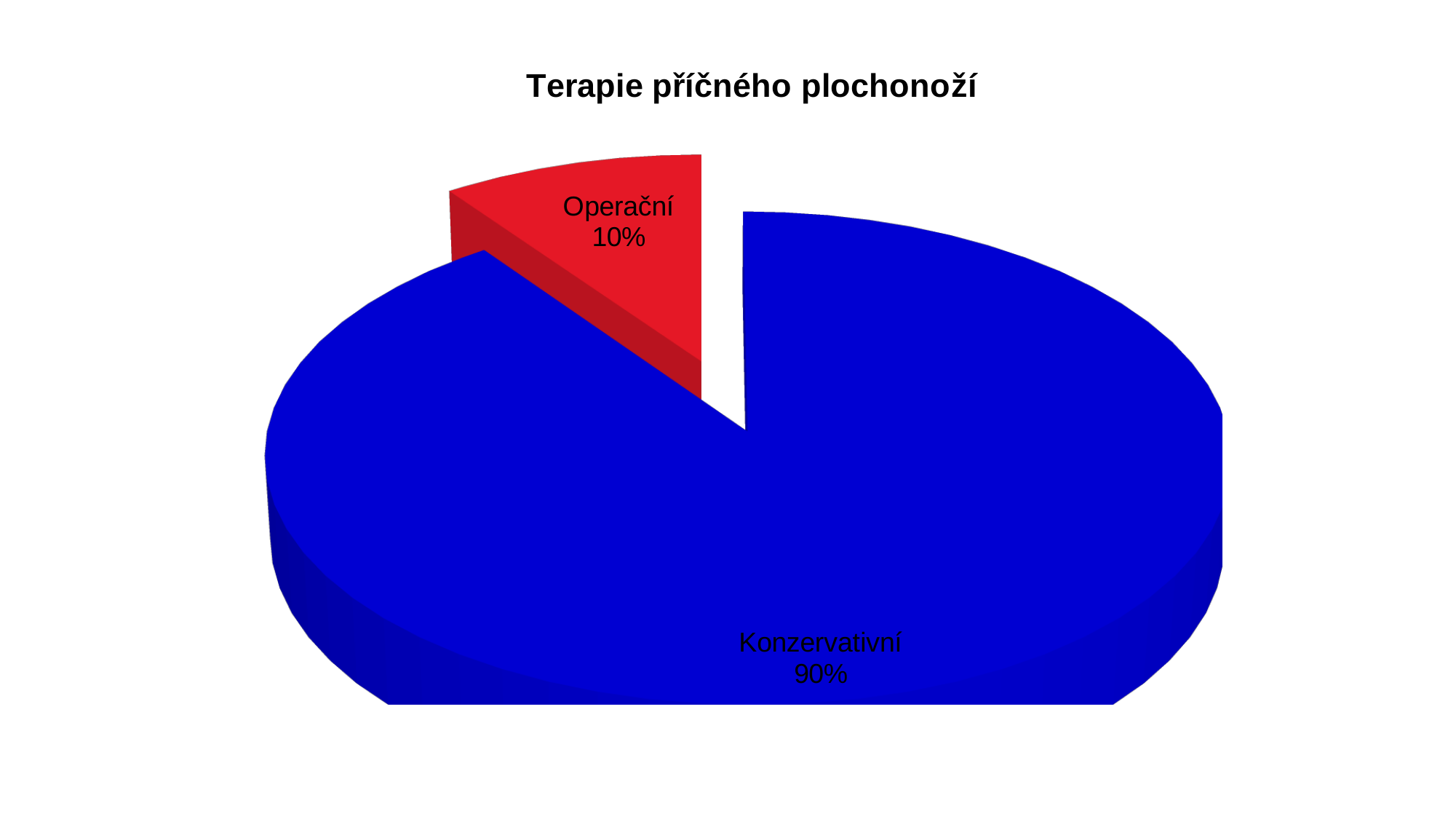
What type of chart is shown on the slide? pie chart Which is larger, the Operační slice or the Konzervativní slice? Konzervativní Which slice is the largest in the pie chart? Konzervativní What is the title of the chart? Terapie příčného plochonoží What is the difference in percentage points between the Konzervativní and Operační slices? 80 What share of the pie does the Konzervativní slice represent? 90% What colour is the Operační slice? red What share of the pie does the Operační slice represent? 10% How many slices does the pie chart have? 2 Which slice is the smallest in the pie chart? Operační